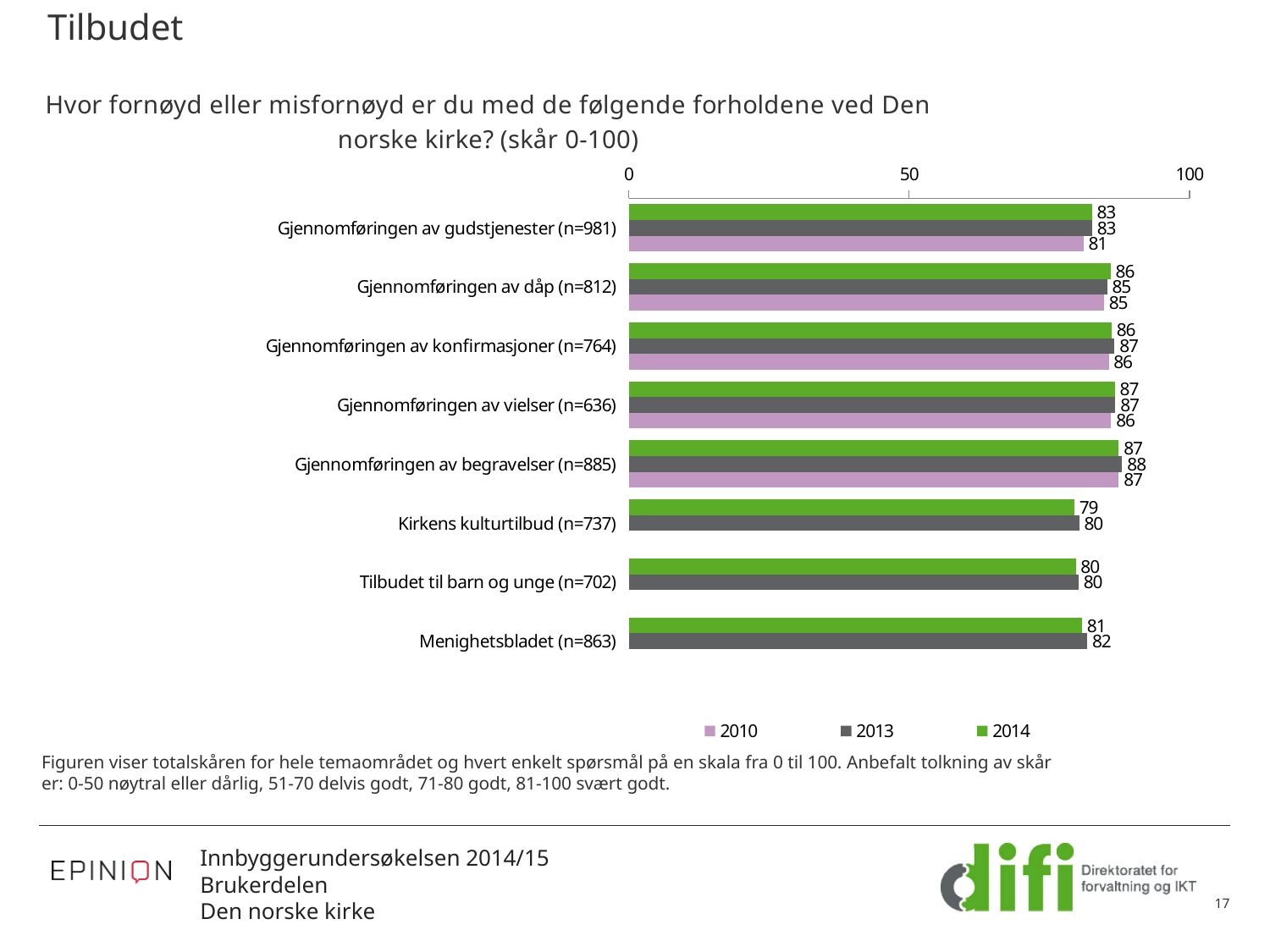
How many series does the legend list? 3 Which category has the lowest 2014 value? Kirkens kulturtilbud (n=737) Which series is shown in green in the legend? 2014 What is the 2014 value for Kirkens kulturtilbud (n=737)? 79 What is the difference between the 2014 value for Gjennomføringen av begravelser (n=885) and the 2014 value for Tilbudet til barn og unge (n=702)? 7 What is the 2013 value for Menighetsbladet (n=863)? 82 What kind of chart is shown on the slide? bar chart How many categories are shown on the chart? 8 What is the 2014 value for Gjennomføringen av gudstjenester (n=981)? 83 Which category has the highest 2013 value? Gjennomføringen av begravelser (n=885) Which is larger: the 2013 value for Gjennomføringen av konfirmasjoner (n=764) or the 2013 value for Gjennomføringen av gudstjenester (n=981)? Gjennomføringen av konfirmasjoner (n=764) What is the 2010 value for Gjennomføringen av dåp (n=812)? 85